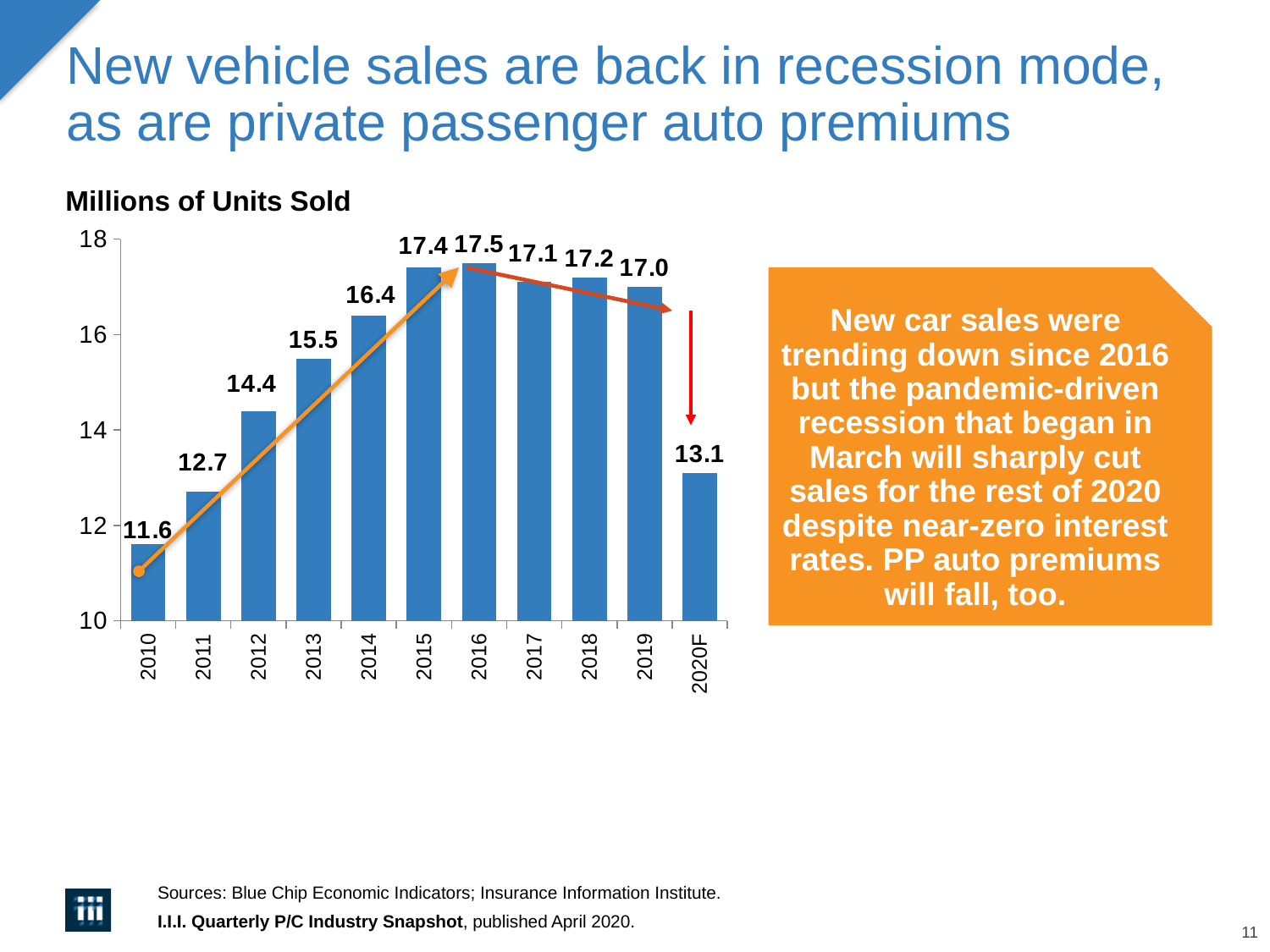
What is the difference between the values for 2019 and 2020F in the Millions of Units Sold chart? 3.9 What is the value for 2020F in the Millions of Units Sold chart? 13.1 Which year has the lowest value in the Millions of Units Sold chart? 2010 What is the difference between the values for 2015 and 2010 in the Millions of Units Sold chart? 5.8 What is the value for 2010 in the Millions of Units Sold chart? 11.6 Is the value for 2012 greater or less than 14 in the Millions of Units Sold chart? greater Which year has the highest value in the Millions of Units Sold chart? 2016 What kind of chart is the Millions of Units Sold chart? bar chart How many years are shown on the x axis of the Millions of Units Sold chart? 11 Do the values in the Millions of Units Sold chart rise or fall from 2010 to 2016? rise Which is larger in the Millions of Units Sold chart, the value for 2013 or the value for 2018? 2018 What is the value for 2014 in the Millions of Units Sold chart? 16.4